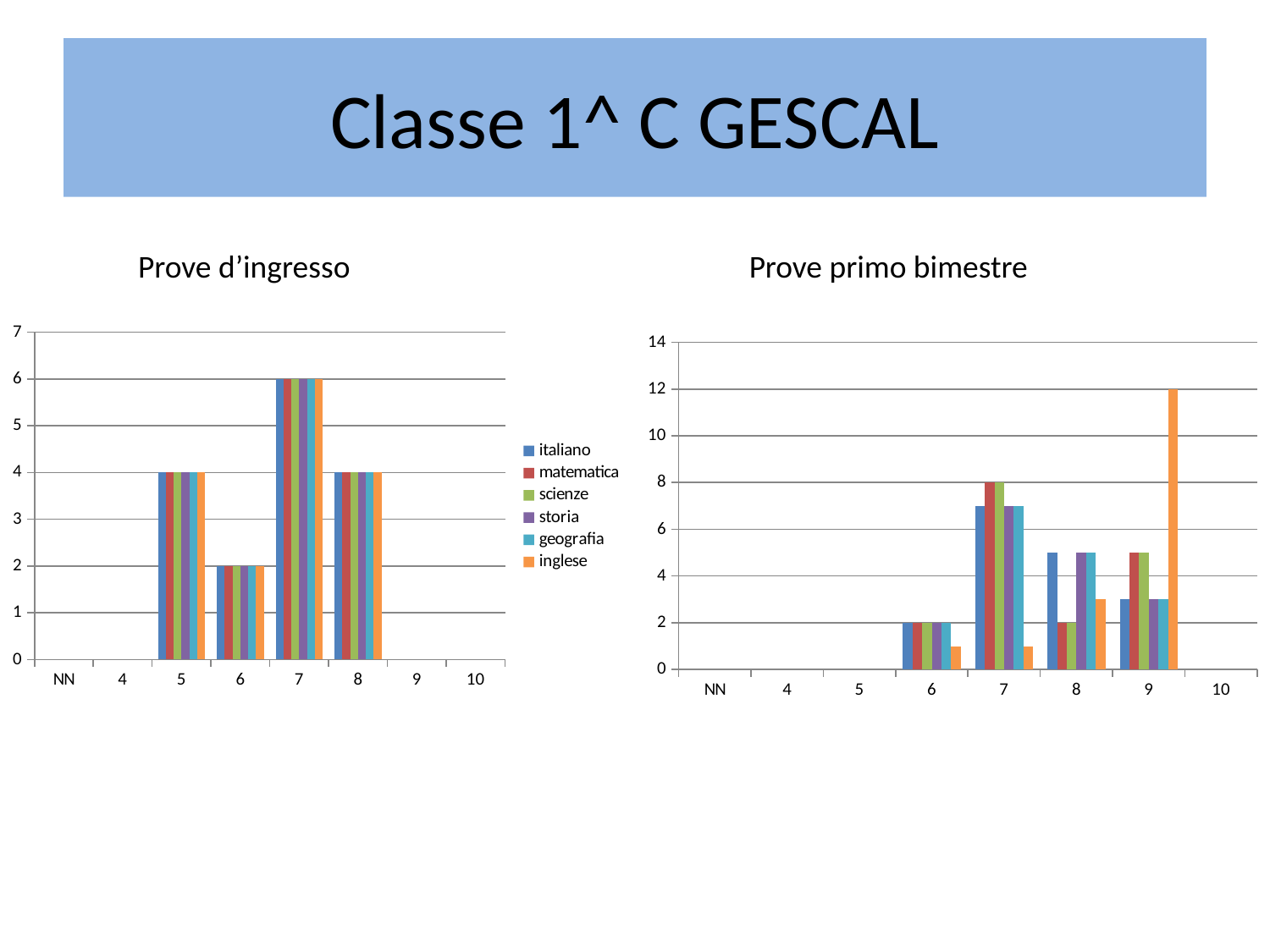
In the 'Prove d'ingresso' chart, is the inglese value larger at category 5 or at category 6? 5 In the 'Prove primo bimestre' chart, at which category does the tallest bar appear? 9 Which series is listed last in the legend of the 'Prove d'ingresso' chart? inglese How many series does the legend of the 'Prove d'ingresso' chart list? 6 In the 'Prove primo bimestre' chart, what is the value of the tallest bar? 12 In the 'Prove d'ingresso' chart, what is the difference between the italiano value at category 7 and at category 6? 4 In the 'Prove d'ingresso' chart, which category has the highest bars? 7 In the 'Prove d'ingresso' chart, what is the value for italiano at category 7? 6 In the 'Prove primo bimestre' chart, is the value of the first (blue) bar at category 7 greater or less than 6? greater How many categories are shown on the x axis of the 'Prove primo bimestre' chart? 8 What kind of chart is the 'Prove primo bimestre' chart? bar chart In the 'Prove d'ingresso' chart, what is the value for matematica at category 6? 2